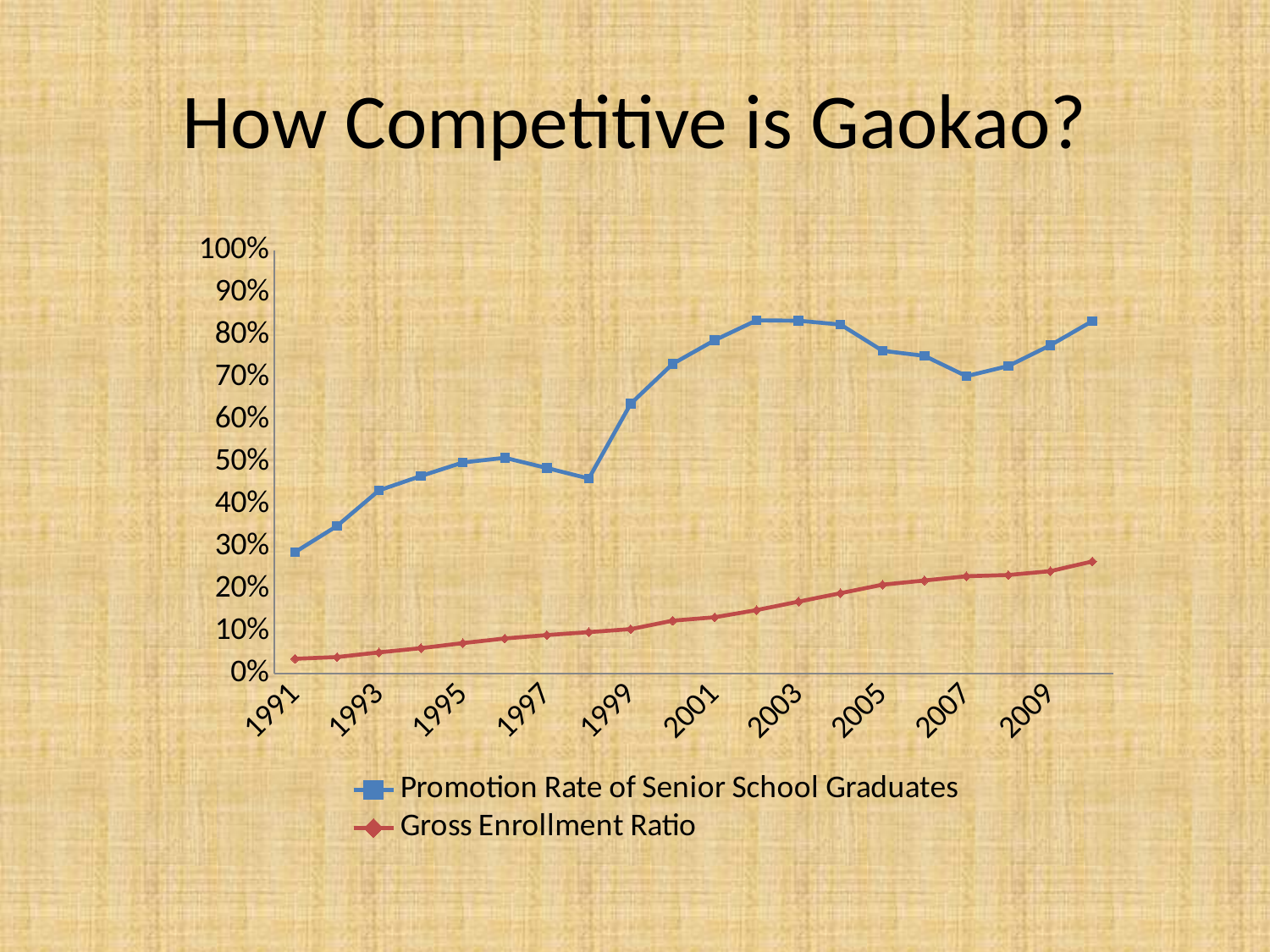
What is the title of the slide containing the chart? How Competitive is Gaokao? Which series is drawn in red with diamond markers? Gross Enrollment Ratio In which year is the Gross Enrollment Ratio highest? 2010 In which year is the Promotion Rate of Senior School Graduates lowest? 1991 Is the Promotion Rate of Senior School Graduates in 1991 greater or less than 30%? less How many series does the legend list? 2 Is the Gross Enrollment Ratio in 1991 greater or less than 10%? less What kind of chart is shown on the slide? line chart Is the Gross Enrollment Ratio at the last point (2010) greater or less than 20%? greater In 2005, which series has the higher value: Promotion Rate of Senior School Graduates or Gross Enrollment Ratio? Promotion Rate of Senior School Graduates Does the Gross Enrollment Ratio rise or fall from 1991 to 2010? rise